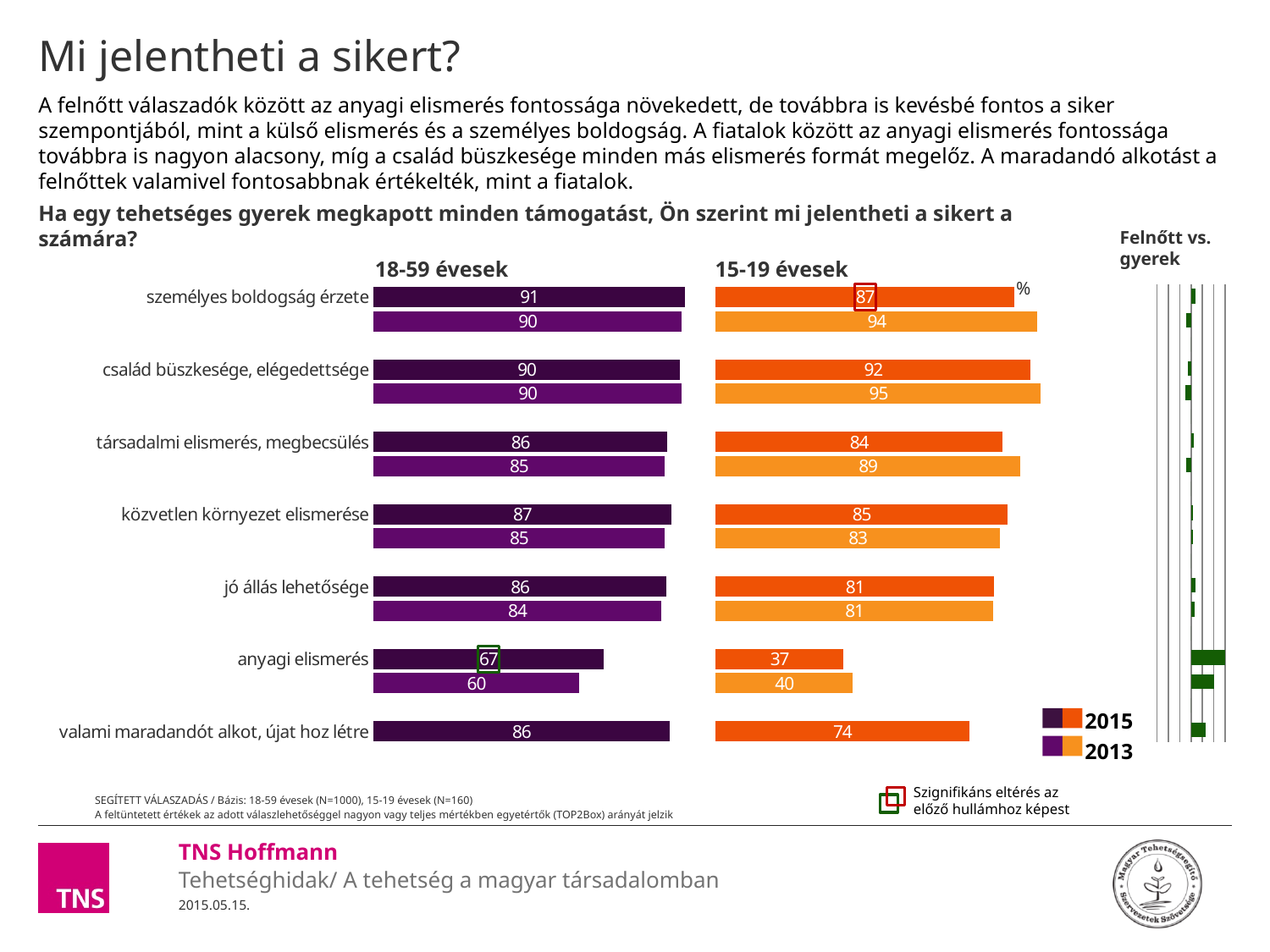
In the "15-19 évesek" chart, what is the difference between the 2013 and 2015 values for "társadalmi elismerés, megbecsülés"? 5 In the "15-19 évesek" chart, what is the 2015 value for "valami maradandót alkot, újat hoz létre"? 74 Which years are listed in the legend? 2015 and 2013 How many series does the legend list? 2 In the "15-19 évesek" chart, what is the 2013 value for "személyes boldogság érzete"? 94 In the "15-19 évesek" chart, which category has the highest 2013 value? család büszkesége, elégedettsége In the "18-59 évesek" chart, what is the 2015 value for "anyagi elismerés"? 67 For "anyagi elismerés" in 2015, which is larger: the value in the "18-59 évesek" chart or the value in the "15-19 évesek" chart? 18-59 évesek In the "18-59 évesek" chart, which category has the lowest 2015 value? anyagi elismerés In the "15-19 évesek" chart, how many categories are shown? 7 What type of chart is the "18-59 évesek" chart? bar chart In the "18-59 évesek" chart, what is the difference between the 2015 and 2013 values for "anyagi elismerés"? 7